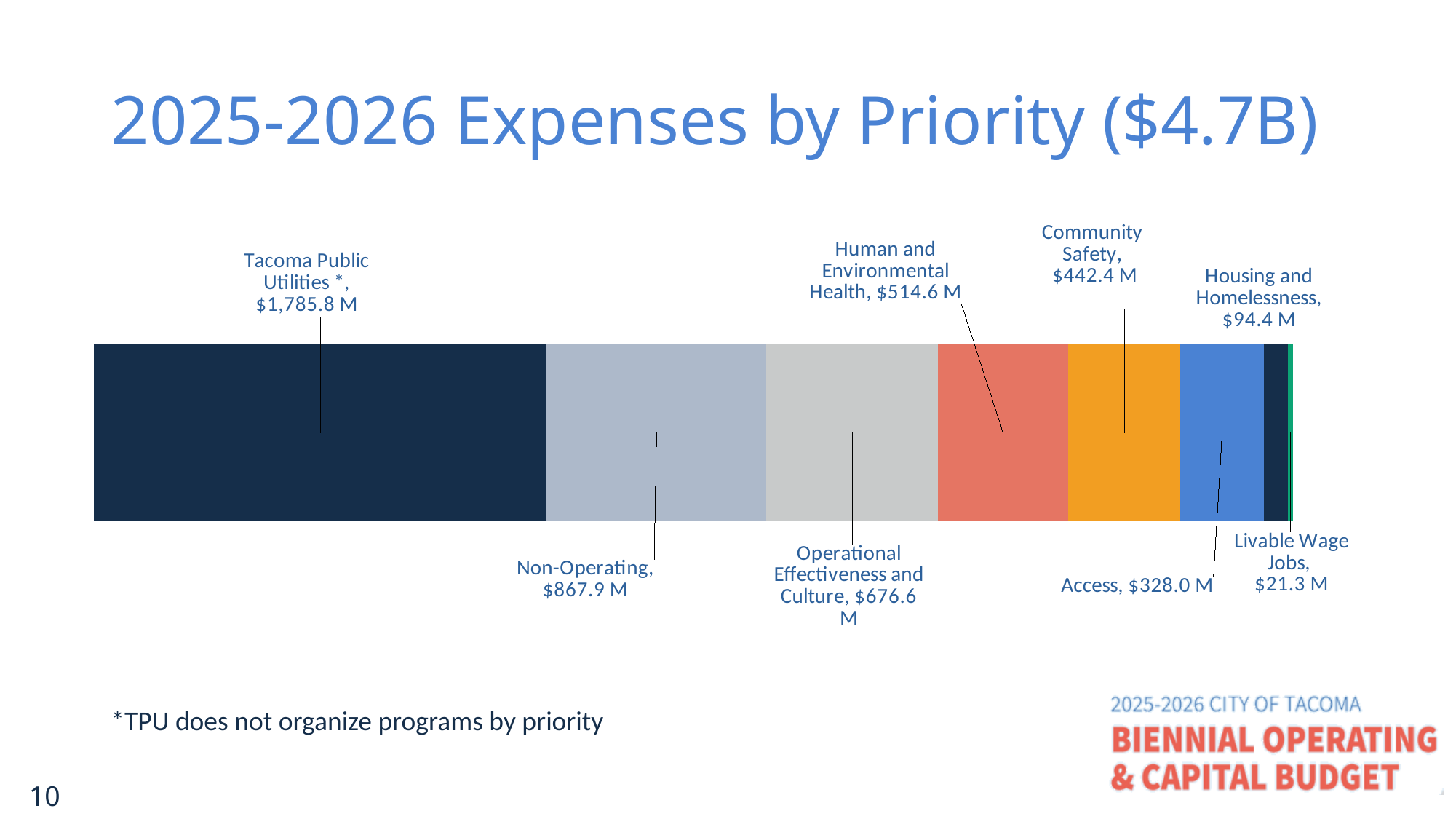
What is the title of the chart? 2025-2026 Expenses by Priority ($4.7B) Which is larger, Community Safety or Access? Community Safety What is the value for Livable Wage Jobs? $21.3 M Which priority has the smallest expense? Livable Wage Jobs What is the value for Non-Operating? $867.9 M What is the value for Human and Environmental Health? $514.6 M What type of chart is shown on the slide? Stacked bar chart What is the difference between Non-Operating and Operational Effectiveness and Culture? $191.3 M Which priority has the largest expense? Tacoma Public Utilities What is the value for Tacoma Public Utilities? $1,785.8 M What is the value for Access? $328.0 M How many segments (priorities) are shown in the bar? 8